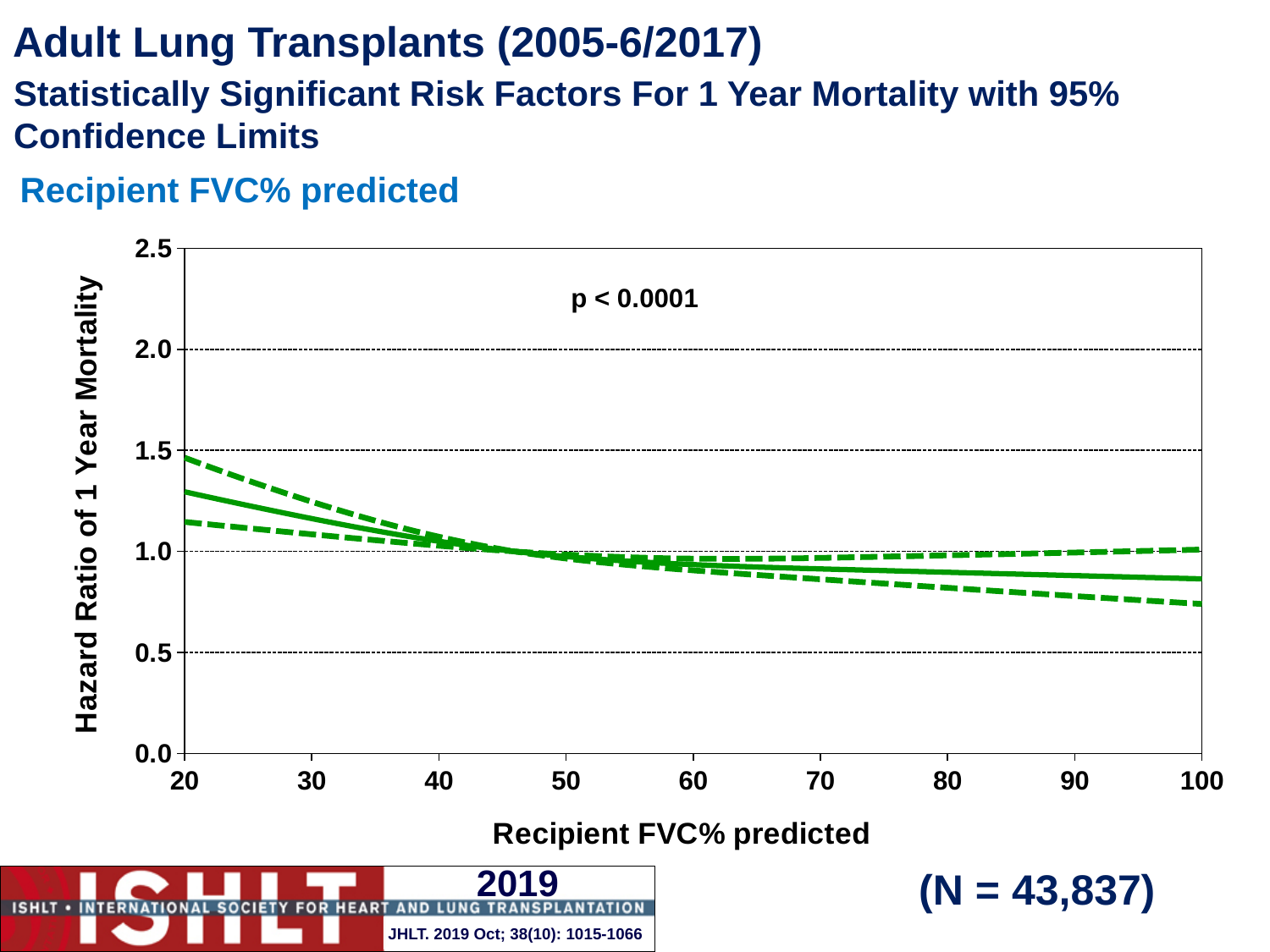
What p-value is printed on the chart? p < 0.0001 Is the hazard ratio on the solid line at Recipient FVC% predicted of 20 greater or less than 1.0? greater Is the upper dashed confidence limit at Recipient FVC% predicted of 20 greater or less than 1.5? less Is the hazard ratio on the solid line at Recipient FVC% predicted of 80 greater or less than 1.0? less What kind of chart is shown on the slide? line chart How many lines are plotted on the chart (including the confidence limits)? 3 Is the hazard ratio on the solid line higher at Recipient FVC% predicted of 20 or at 100? 20 Does the hazard ratio (solid line) rise or fall as Recipient FVC% predicted increases from 20 to 100? fall What is the label of the y axis? Hazard Ratio of 1 Year Mortality